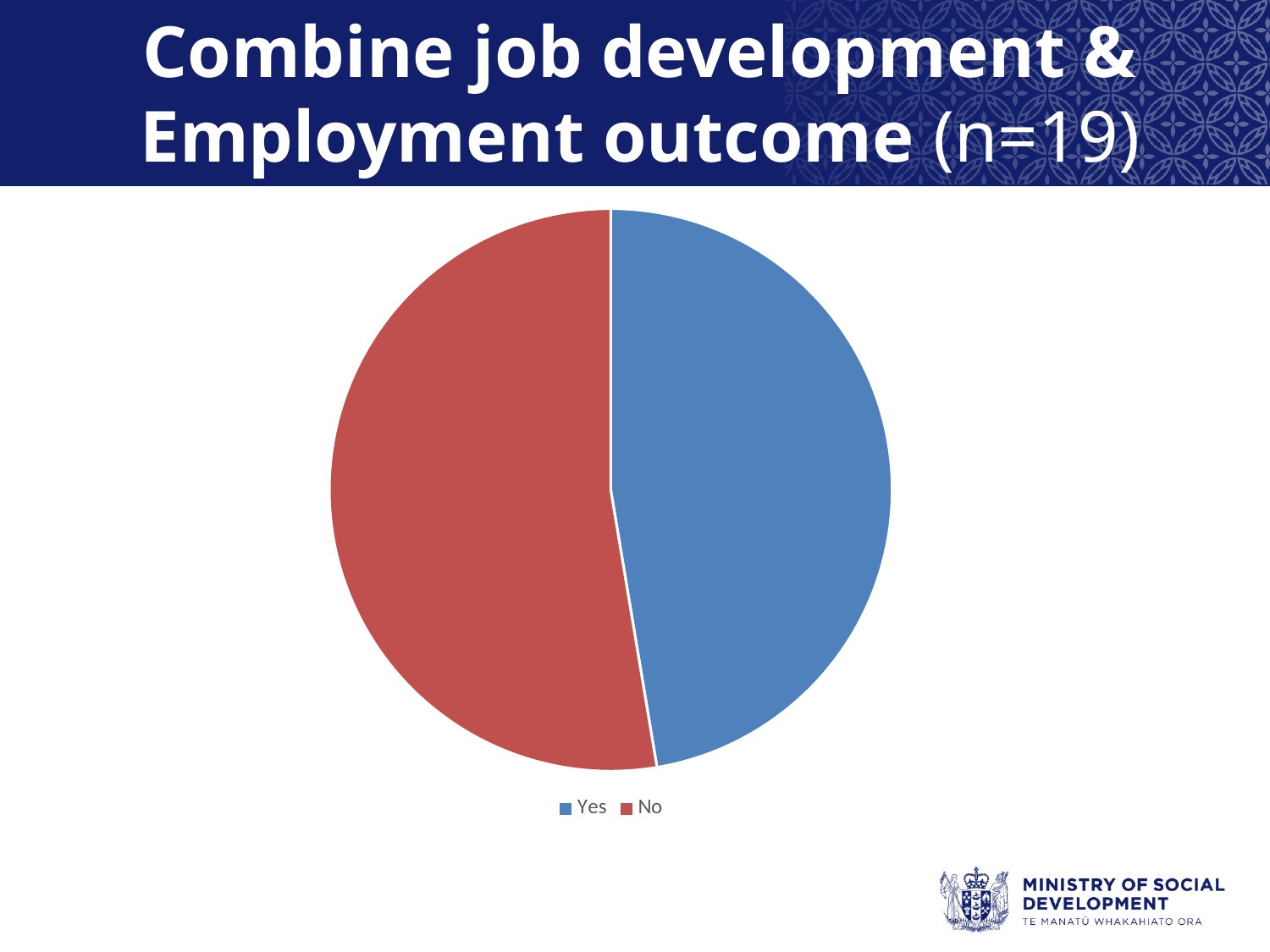
What are the two categories shown in the legend? Yes and No What is the sample size (n) given in the slide title? 19 What kind of chart is shown on the slide? pie chart Which colour represents the "No" slice in the pie chart? red How many entries does the legend list? 2 How many slices does the pie chart have? 2